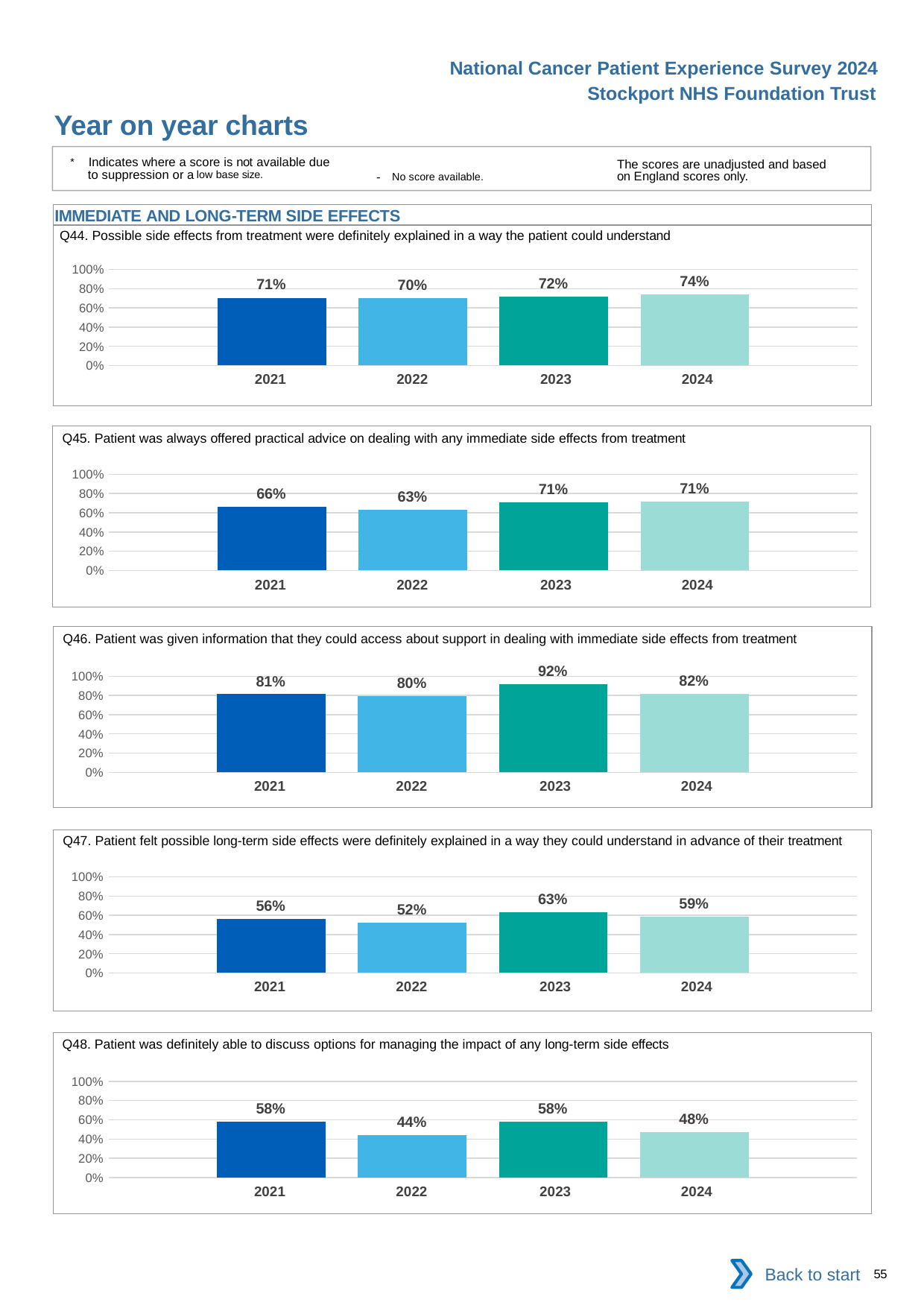
In the Q47 chart, which is larger, the value for 2023 or the value for 2024? 2023 In the Q46 chart, what is the difference between the 2023 and 2024 values? 10% What kind of chart is the Q45 chart? bar chart In the Q44 chart, what is the value for 2024? 74% In the Q46 chart, which year has the highest value? 2023 In the Q48 chart, is the value for 2022 greater or less than 60%? less How many years are shown in the Q44 chart? 4 In the Q47 chart, what is the value for 2022? 52% In the Q45 chart, what is the value for 2021? 66% In the Q48 chart, what is the difference between the 2021 and 2022 values? 14% In the Q47 chart, what is the difference between the 2021 and 2023 values? 7% In the Q45 chart, which year has the lowest value? 2022